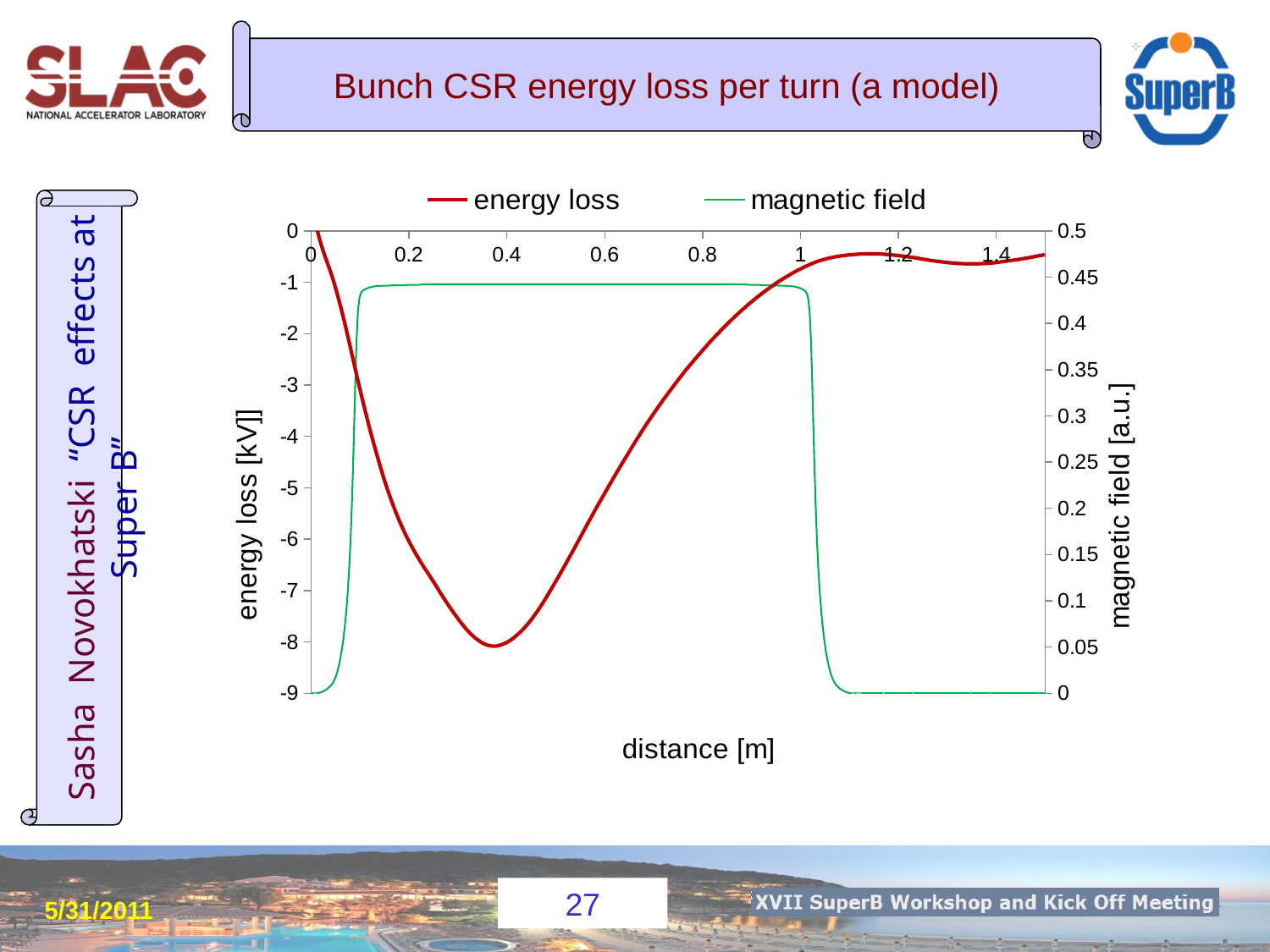
Is the energy loss at a distance of 1 m greater or less than -2 kV? greater Does the energy loss curve rise or fall as distance increases from 0.5 m to 1 m? rise Does the energy loss curve rise or fall as distance increases from 0 to 0.3 m? fall What is the title of the chart's x axis? distance [m] What kind of chart is shown on the slide? line chart Which series is plotted in red? energy loss Is the magnetic field at a distance of 1.2 m greater or less than 0.1? less Is the magnetic field at a distance of 0.6 m greater or less than 0.4? greater How many series does the chart's legend list? 2 What are the two series named in the chart's legend? energy loss and magnetic field